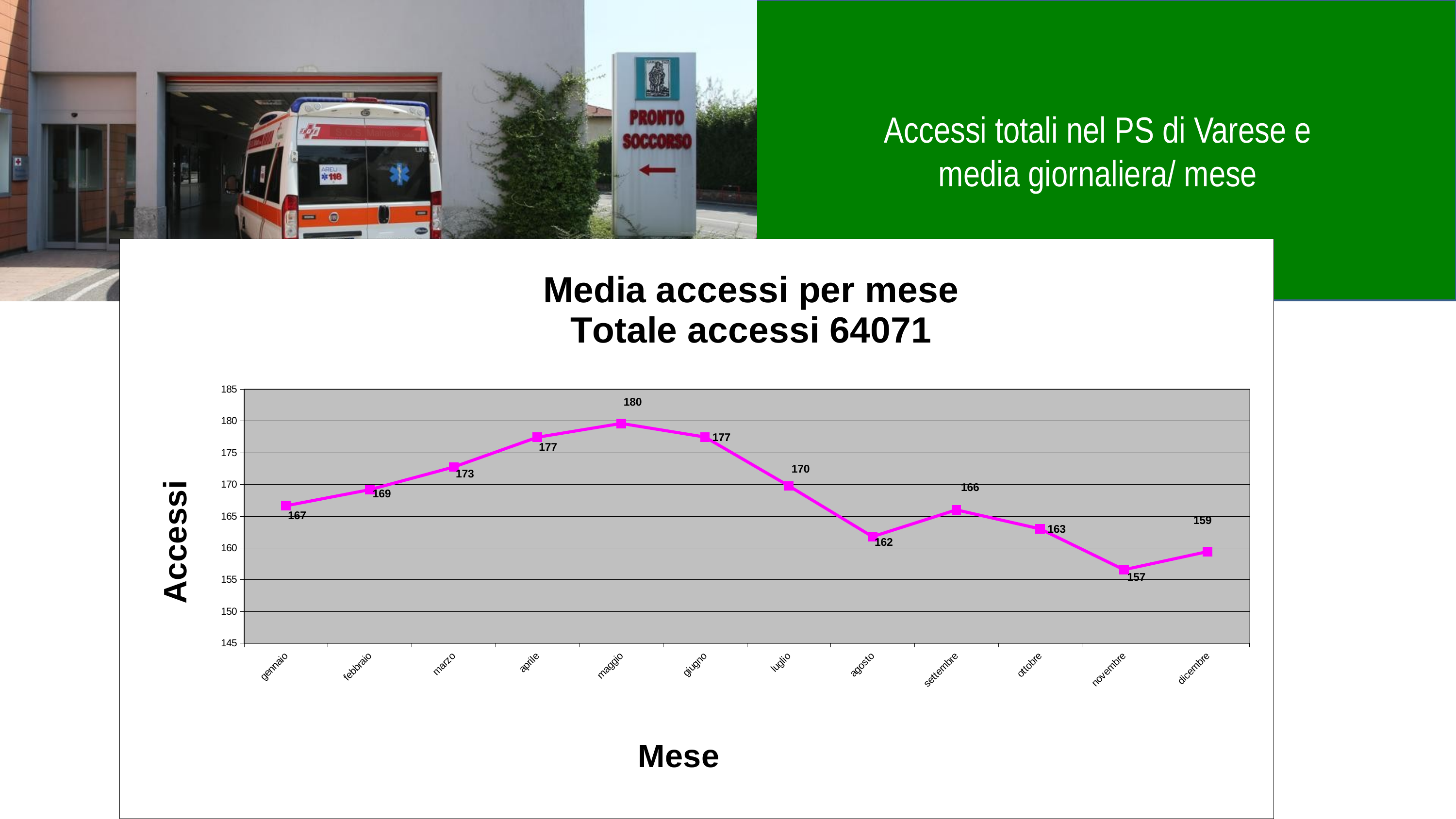
Which month has the highest value? maggio What is the value for gennaio? 167 What is the value for novembre? 157 Which is larger, the value for settembre or the value for agosto? settembre Is the value for luglio greater or less than 165? greater What is the title of the chart? Media accessi per mese Totale accessi 64071 What is the value for maggio? 180 How many months are plotted on the chart? 12 Which month has the lowest value? novembre What kind of chart is shown? line chart What is the difference between the values for maggio and novembre? 23 Do the values rise or fall from gennaio to maggio? rise